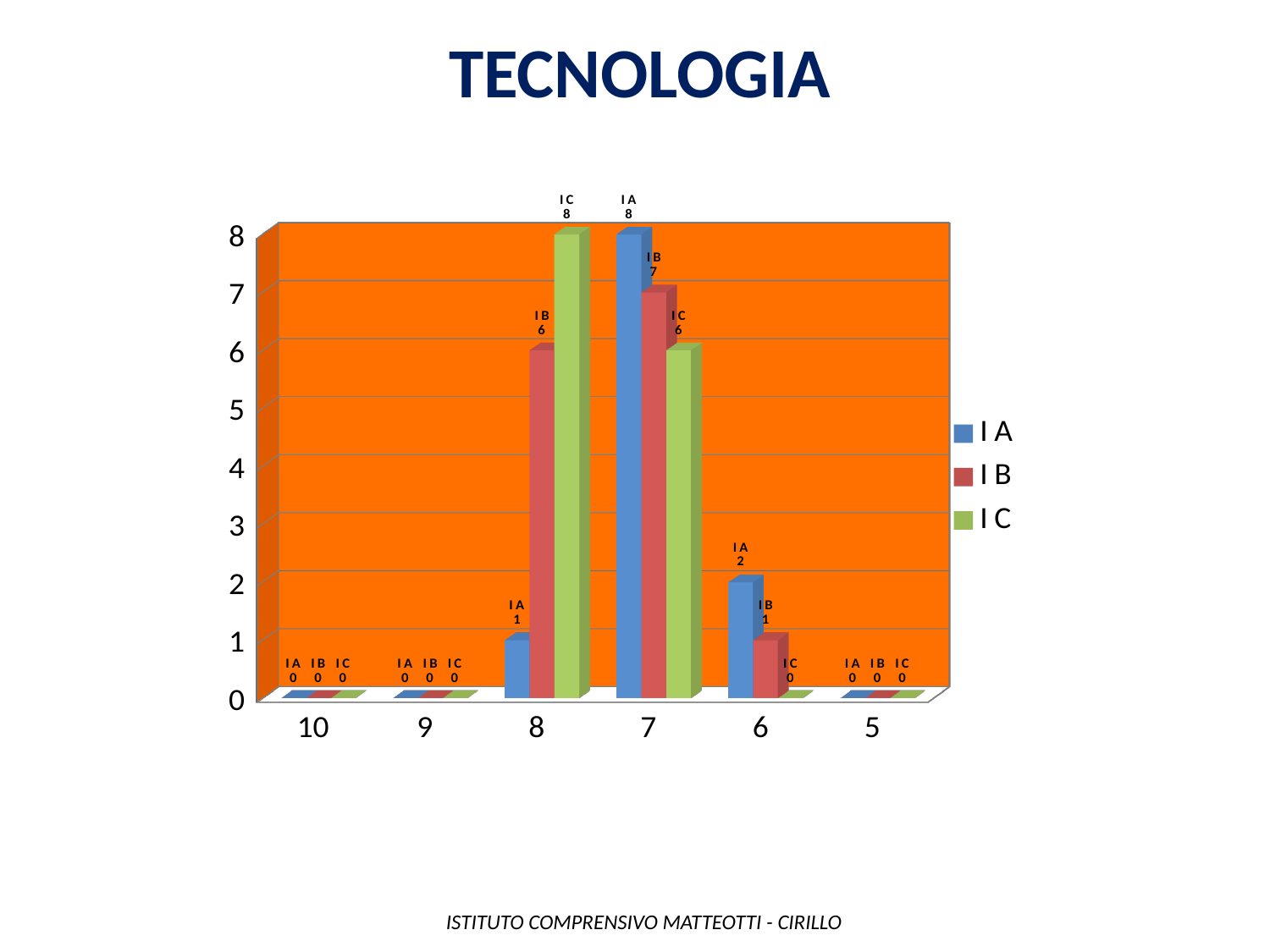
Which category has the highest value for I A? 7 How many categories are shown on the x axis? 6 How many series does the legend list? 3 Which is larger at category 7: I A or I C? I A What is the value for I B at category 7? 7 Which category has the highest value for I C? 8 What is the value for I C at category 8? 8 What is the title of the chart? TECNOLOGIA What is the difference between I C and I A at category 8? 7 What is the value for I A at category 8? 1 What kind of chart is shown on the slide? Bar chart What is the value for I A at category 6? 2